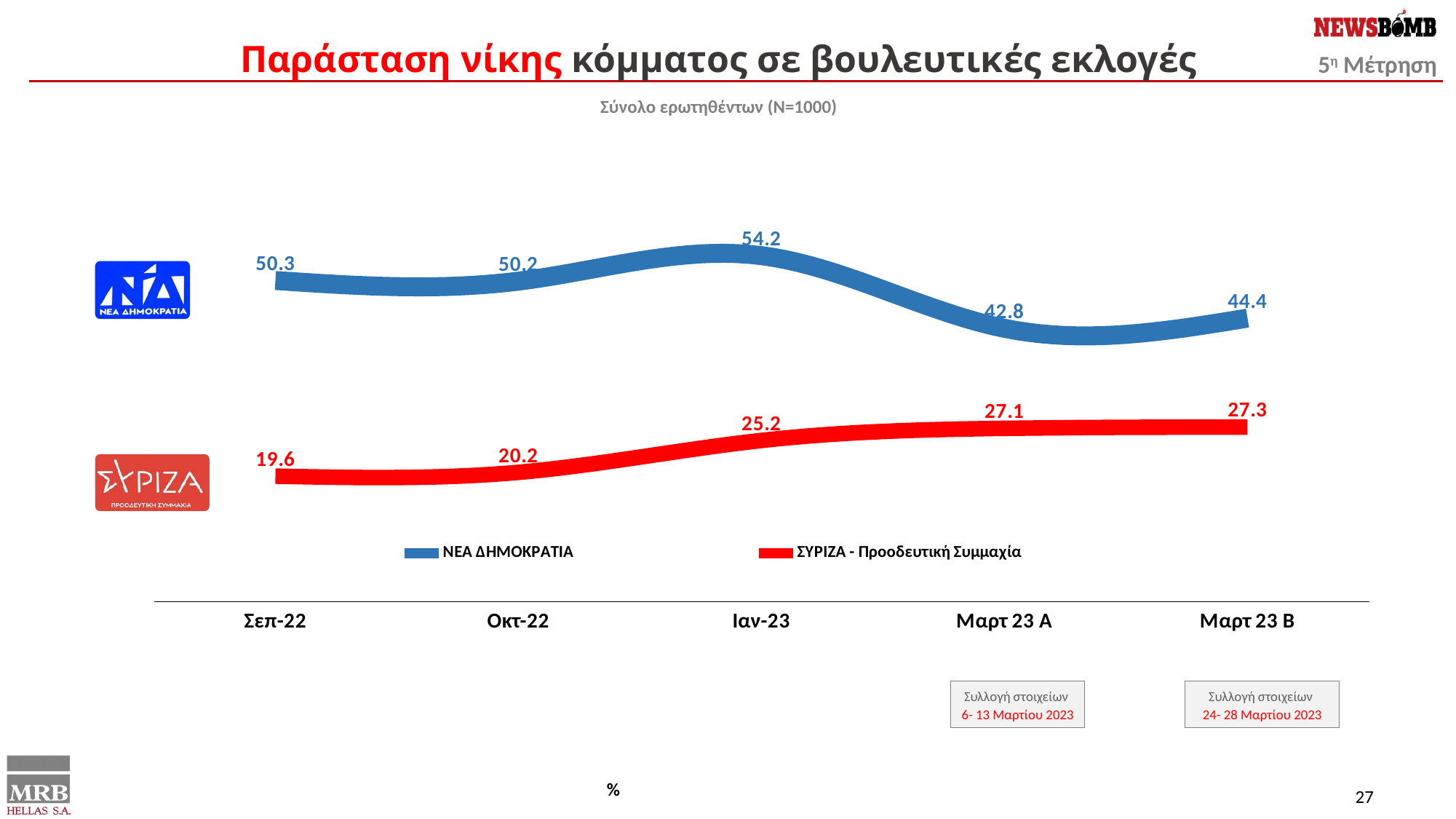
What is the value for ΝΕΑ ΔΗΜΟΚΡΑΤΙΑ at Ιαν-23? 54.2 What kind of chart is shown on the slide? line chart Which series has the larger value at Ιαν-23, ΝΕΑ ΔΗΜΟΚΡΑΤΙΑ or ΣΥΡΙΖΑ - Προοδευτική Συμμαχία? ΝΕΑ ΔΗΜΟΚΡΑΤΙΑ How many points are shown on the x axis? 5 What is the value for ΣΥΡΙΖΑ - Προοδευτική Συμμαχία at Σεπ-22? 19.6 What is the value for ΝΕΑ ΔΗΜΟΚΡΑΤΙΑ at Μαρτ 23 Β? 44.4 At which x-axis point is the ΝΕΑ ΔΗΜΟΚΡΑΤΙΑ value lowest? Μαρτ 23 Α What is the difference between the ΝΕΑ ΔΗΜΟΚΡΑΤΙΑ and ΣΥΡΙΖΑ - Προοδευτική Συμμαχία values at Μαρτ 23 Β? 17.1 At which x-axis point is the ΝΕΑ ΔΗΜΟΚΡΑΤΙΑ value highest? Ιαν-23 Does the ΣΥΡΙΖΑ - Προοδευτική Συμμαχία series rise or fall from Σεπ-22 to Μαρτ 23 Β? rise How many series does the legend list? 2 At which x-axis point is the ΣΥΡΙΖΑ - Προοδευτική Συμμαχία value lowest? Σεπ-22